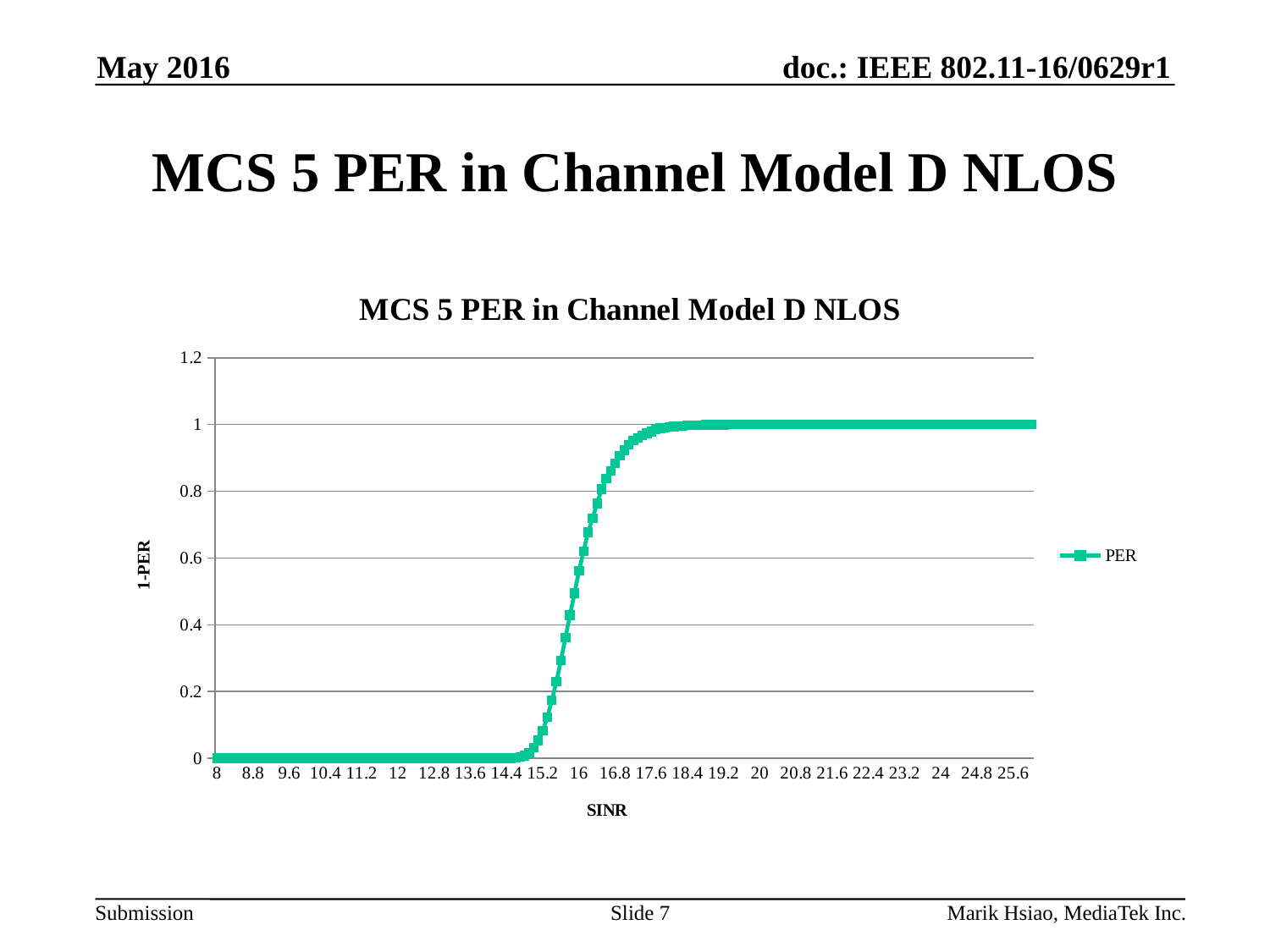
Which has the larger value, SINR 12 or SINR 20? 20 Is the value for SINR 17.6 greater or less than 0.8? greater Is the value for SINR 16.8 greater or less than 0.8? greater How many series does the legend list? 1 What is the title of the chart? MCS 5 PER in Channel Model D NLOS Is the value for SINR 20 greater or less than 0.8? greater Which has the larger value, SINR 16.8 or SINR 15.2? 16.8 What is the label of the series shown in the legend? PER What kind of chart is shown on the slide? line chart Do the plotted values rise or fall as SINR increases from 14.4 to 18.4? rise